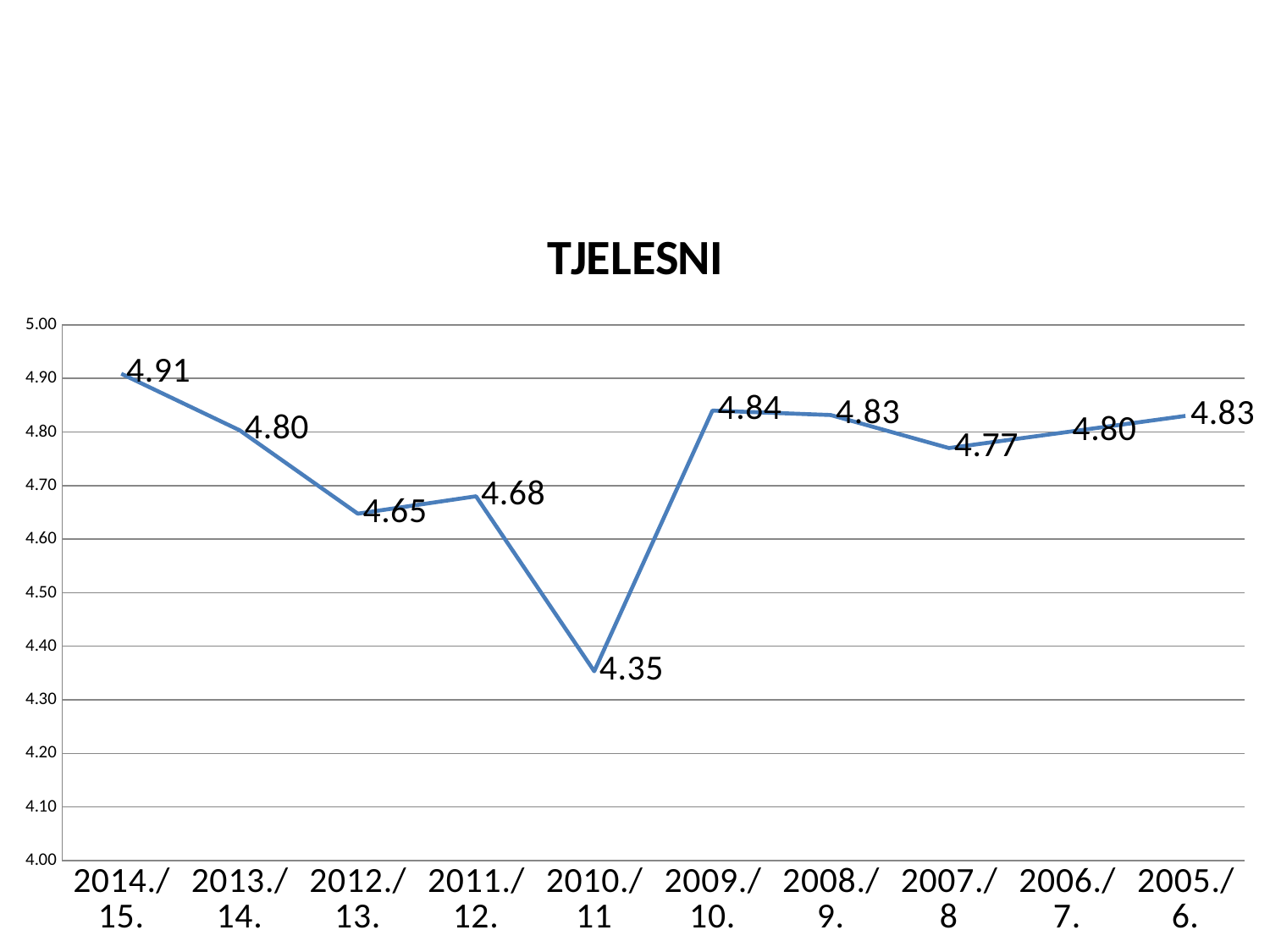
Is the value for 2009./10. greater or less than 4.80? greater Do the values rise or fall from 2014./15. to 2012./13.? fall What kind of chart is this? line chart How many categories are shown on the x axis? 10 What is the value for 2007./8? 4.77 What is the title of the chart? TJELESNI What is the value for 2010./11? 4.35 What is the value for 2014./15.? 4.91 Which category has the highest value? 2014./15. What is the difference between the values for 2014./15. and 2010./11? 0.56 Which is larger, the value for 2012./13. or the value for 2011./12.? 2011./12. Which category has the lowest value? 2010./11